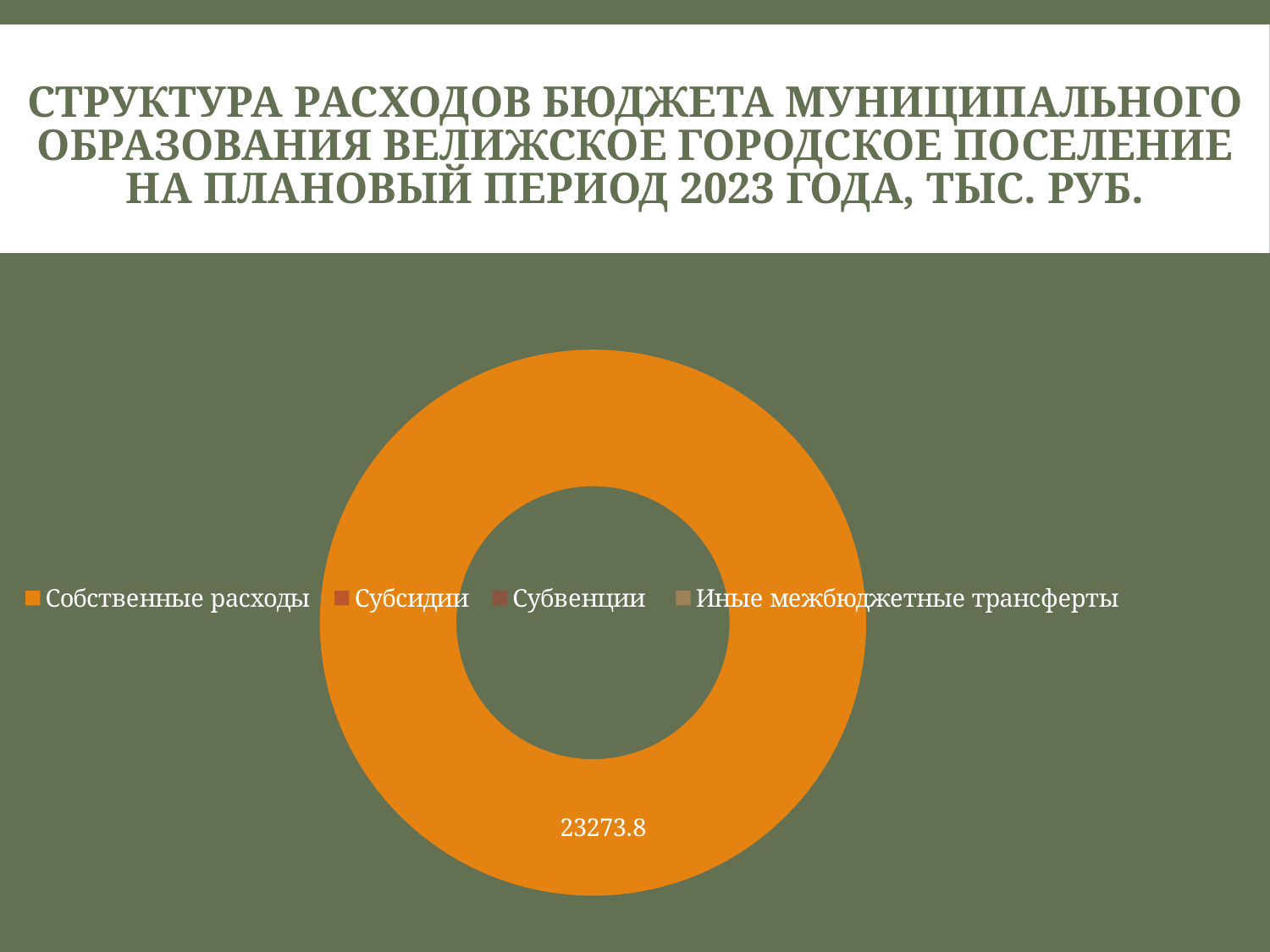
Which category accounts for the largest part of the chart? Собственные расходы What value is shown for Собственные расходы on the chart? 23273.8 What kind of chart is shown on the slide? Doughnut (pie) chart Is the value for Собственные расходы greater or less than 20000? greater Which legend entry is shown in orange? Собственные расходы How many entries does the chart legend list? 4 How many slices are visibly plotted on the doughnut chart? 1 What unit of measurement is stated in the chart title? тыс. руб.